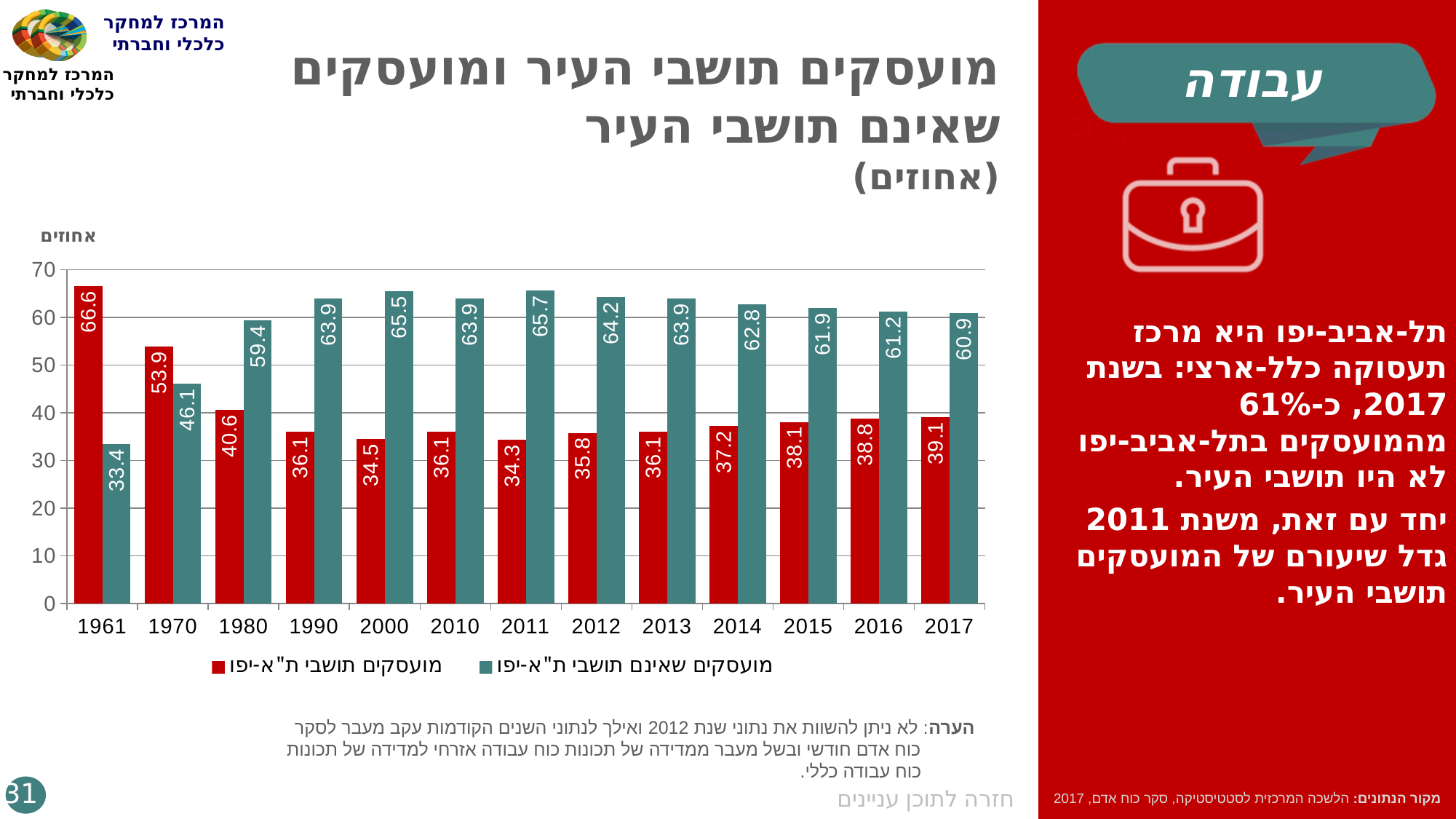
What is the value for מועסקים תושבי ת"א-יפו in 1961? 66.6 Which series has the larger value in 1970? מועסקים תושבי ת"א-יפו What is the value for מועסקים שאינם תושבי ת"א-יפו in 2017? 60.9 What is the value for מועסקים שאינם תושבי ת"א-יפו in 2011? 65.7 Which colour represents מועסקים תושבי ת"א-יפו in the chart? red What type of chart is shown on the slide? bar chart How many years are shown on the x axis? 13 What is the difference between the two series in 1980? 18.8 In which year is the value for מועסקים שאינם תושבי ת"א-יפו the highest? 2011 In which year is the value for מועסקים תושבי ת"א-יפו the lowest? 2011 From 2011 to 2017, does the value for מועסקים תושבי ת"א-יפו rise or fall? rise How many series does the legend list? 2